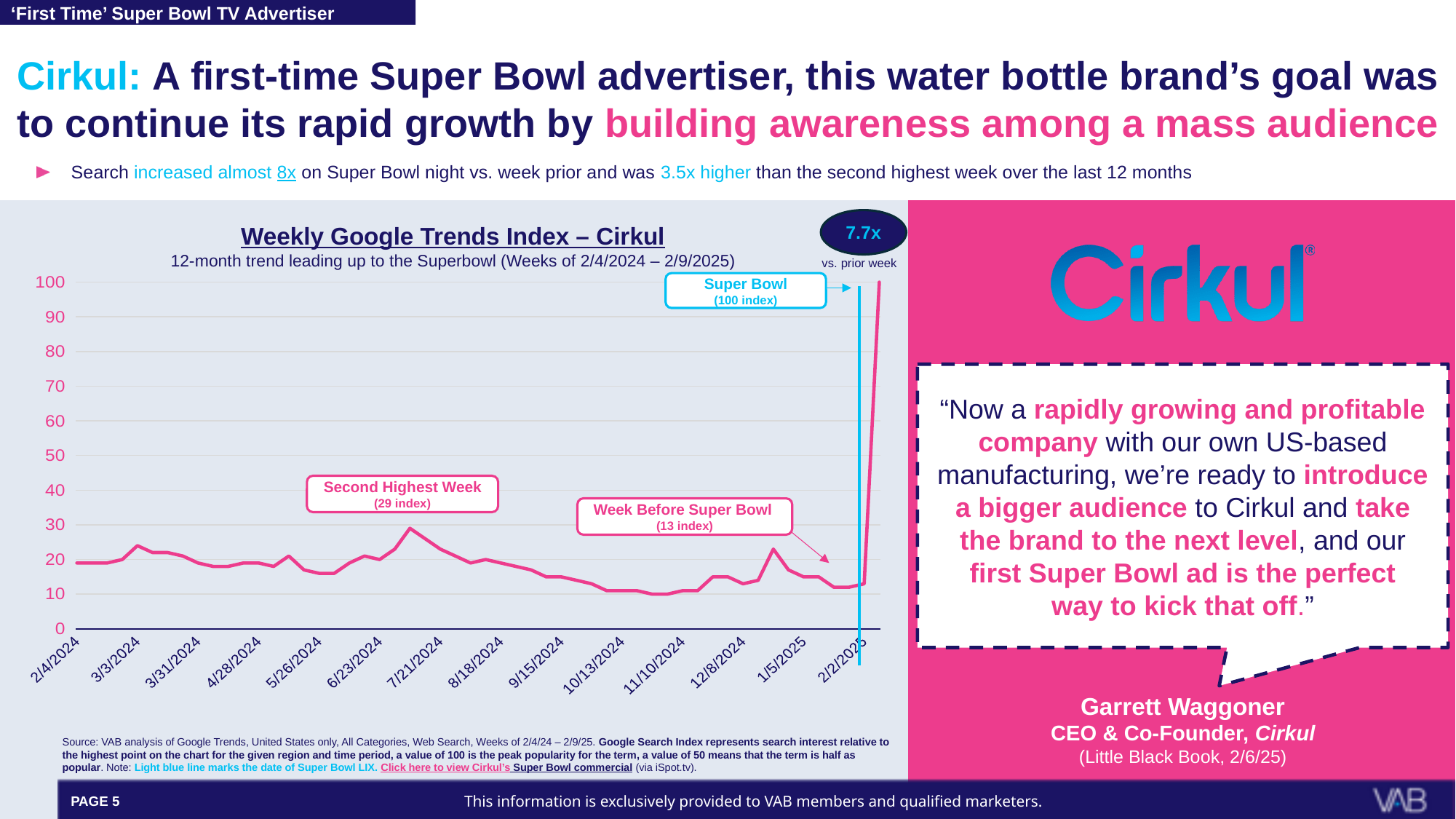
What kind of chart is the Weekly Google Trends Index – Cirkul chart? Line chart What is the difference between the Super Bowl week index and the Week Before Super Bowl index? 87 Is the index value for the week of 2/4/2024 greater or less than 10? greater Which is larger, the Second Highest Week index or the Week Before Super Bowl index? Second Highest Week Is the index value for the week of 10/13/2024 greater or less than 20? less What is the index value labeled for the Second Highest Week? 29 What is the subtitle of the Weekly Google Trends Index – Cirkul chart? 12-month trend leading up to the Superbowl (Weeks of 2/4/2024 – 2/9/2025) Do the index values generally rise or fall between 7/21/2024 and 10/13/2024? fall What is the difference between the Second Highest Week index and the Week Before Super Bowl index? 16 What is the index value labeled for the Week Before Super Bowl? 13 Which week has the highest value on the Weekly Google Trends Index chart? Super Bowl week What is the index value for the Super Bowl week on the Weekly Google Trends Index chart? 100